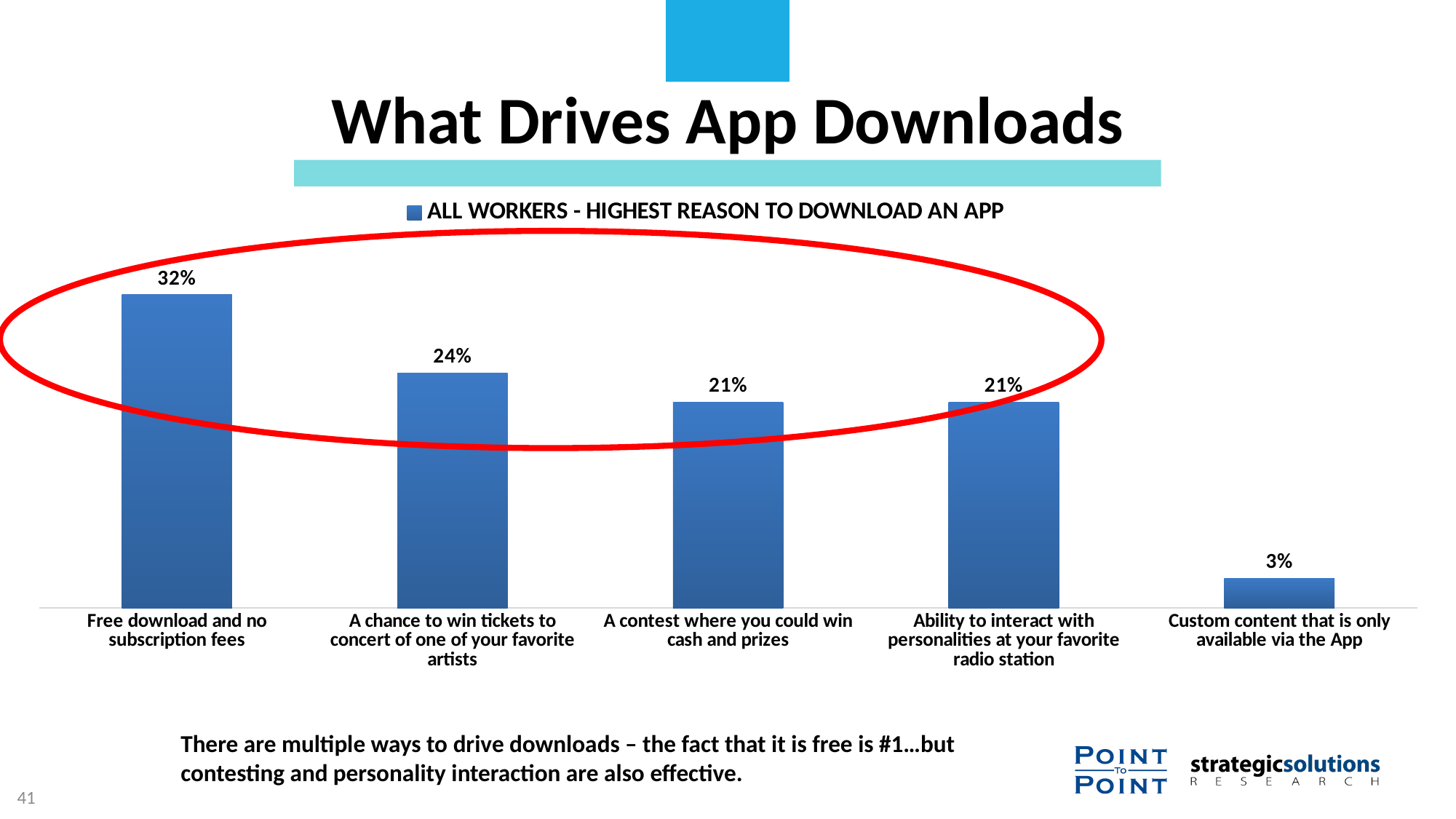
What is the value for "A chance to win tickets to concert of one of your favorite artists"? 24% Which category has the lowest value? Custom content that is only available via the App What is the difference between the values for "A contest where you could win cash and prizes" and "Custom content that is only available via the App"? 18% What series name does the legend show? ALL WORKERS - HIGHEST REASON TO DOWNLOAD AN APP Which category has the highest value? Free download and no subscription fees What is the difference between the values for "Free download and no subscription fees" and "A chance to win tickets to concert of one of your favorite artists"? 8% What is the value for "Ability to interact with personalities at your favorite radio station"? 21% What percentage is shown for "Custom content that is only available via the App"? 3% What kind of chart is shown on the slide? Bar chart How many categories are shown in the chart? 5 What percentage is shown for "Free download and no subscription fees"? 32% Which is larger: the value for "A chance to win tickets to concert of one of your favorite artists" or for "A contest where you could win cash and prizes"? A chance to win tickets to concert of one of your favorite artists